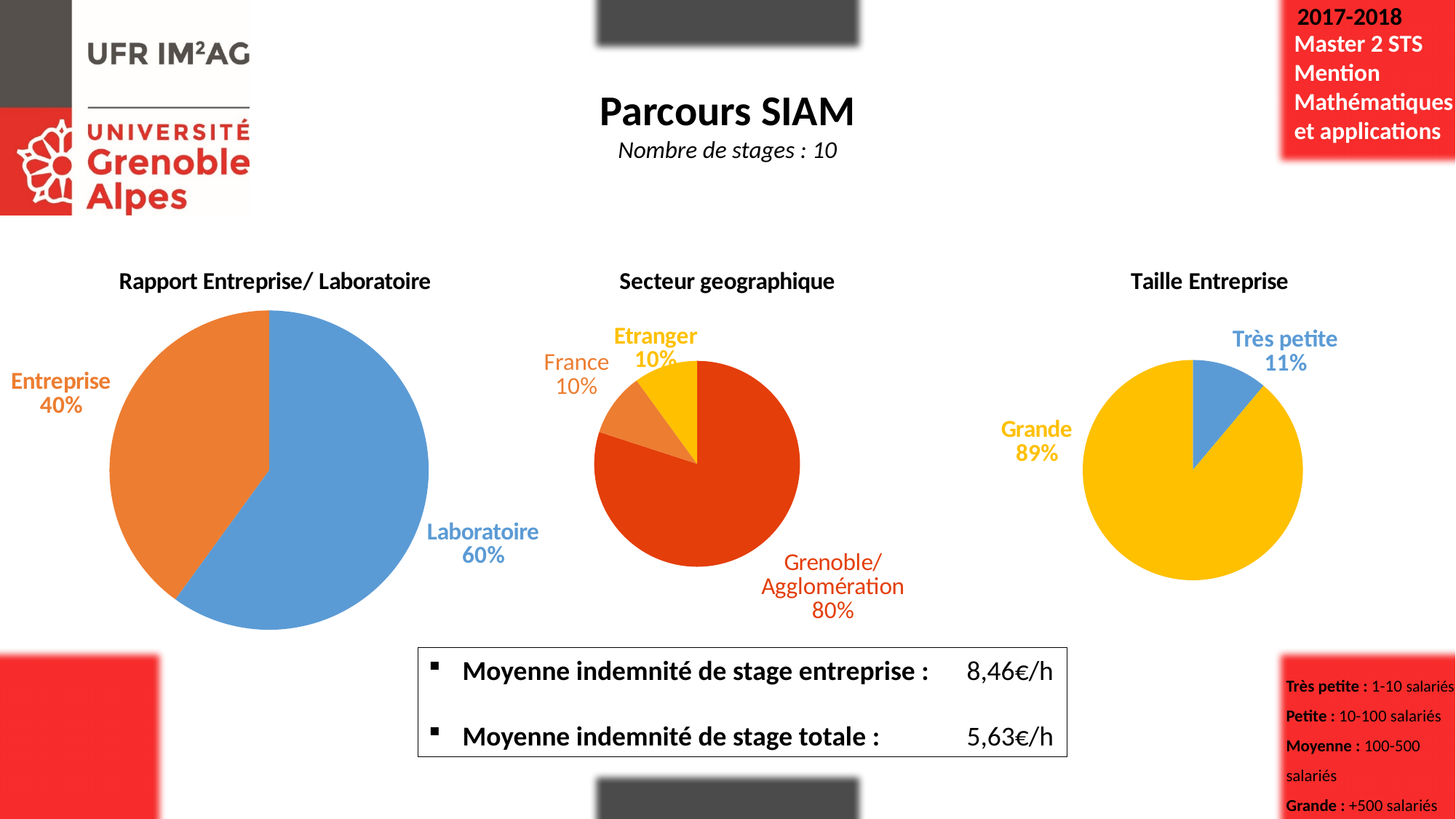
In the 'Rapport Entreprise/ Laboratoire' chart, what colour is the Entreprise slice? Orange In the 'Taille Entreprise' chart, what share does Grande have? 89% In the 'Rapport Entreprise/ Laboratoire' chart, what share does Entreprise have? 40% In the 'Secteur geographique' chart, what is the difference between the Grenoble/ Agglomération share and the France share? 70% In the 'Taille Entreprise' chart, which slice is the smallest? Très petite In the 'Secteur geographique' chart, what share does Grenoble/ Agglomération have? 80% In the 'Rapport Entreprise/ Laboratoire' chart, which slice is the largest? Laboratoire What kind of chart is the 'Taille Entreprise' chart? Pie chart In the 'Secteur geographique' chart, how many slices are there? 3